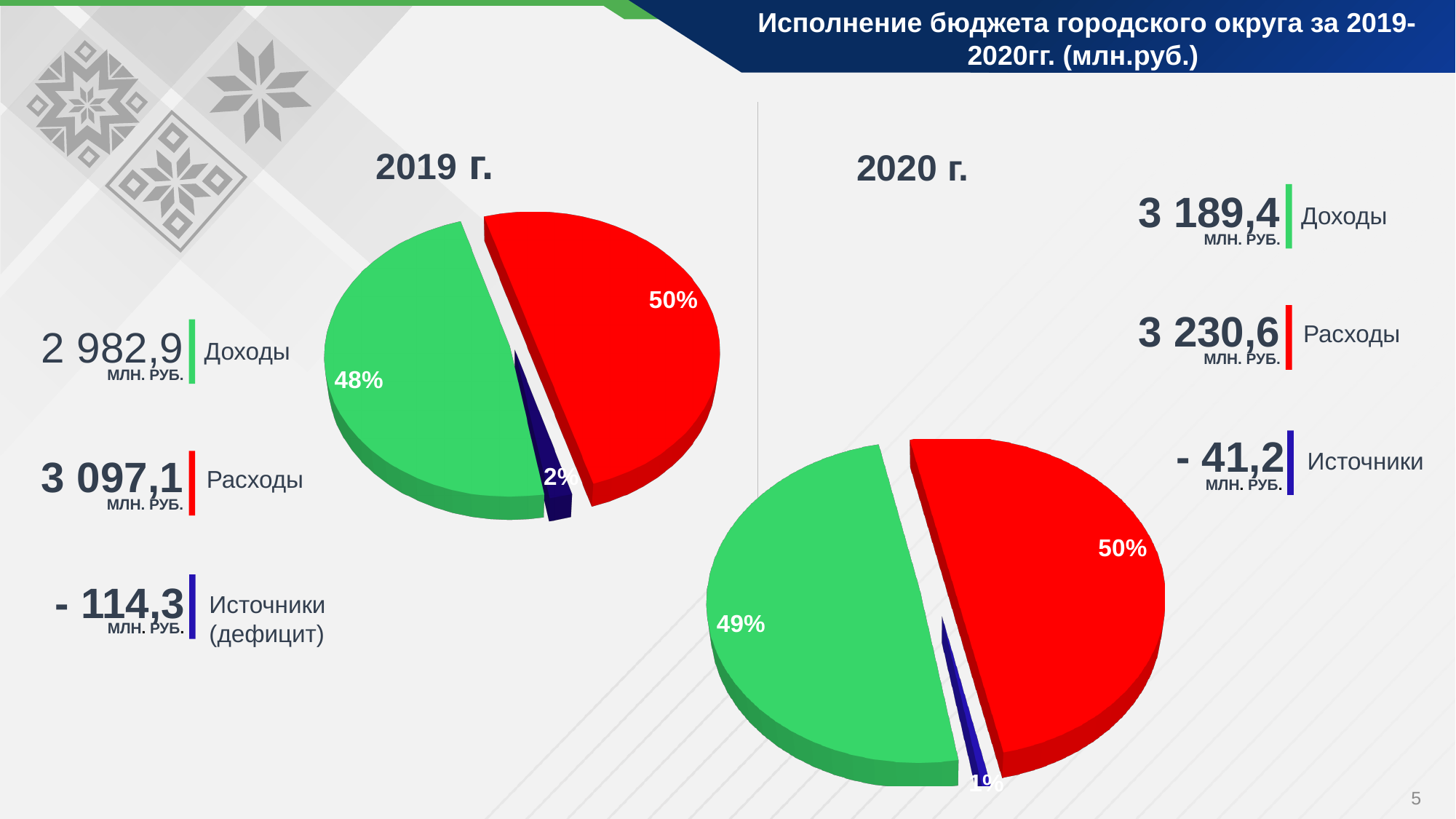
In the 2019 г. pie chart, what share is shown for the red slice? 50% How many slices does the 2020 г. pie chart have? 3 In the 2019 г. pie chart, which slice is the smallest? the dark blue slice (2%) In the 2019 г. pie chart, what share is shown for the green slice? 48% In the 2020 г. pie chart, what share is shown for the dark blue slice? 1% In the 2020 г. pie chart, which slice is the largest? the red slice (50%) What kind of chart is used for the 2019 г. data? pie chart What is the title of the slide containing the two pie charts? Исполнение бюджета городского округа за 2019-2020гг. (млн.руб.) In the 2019 г. pie chart, what is the difference between the red slice's share and the green slice's share? 2%